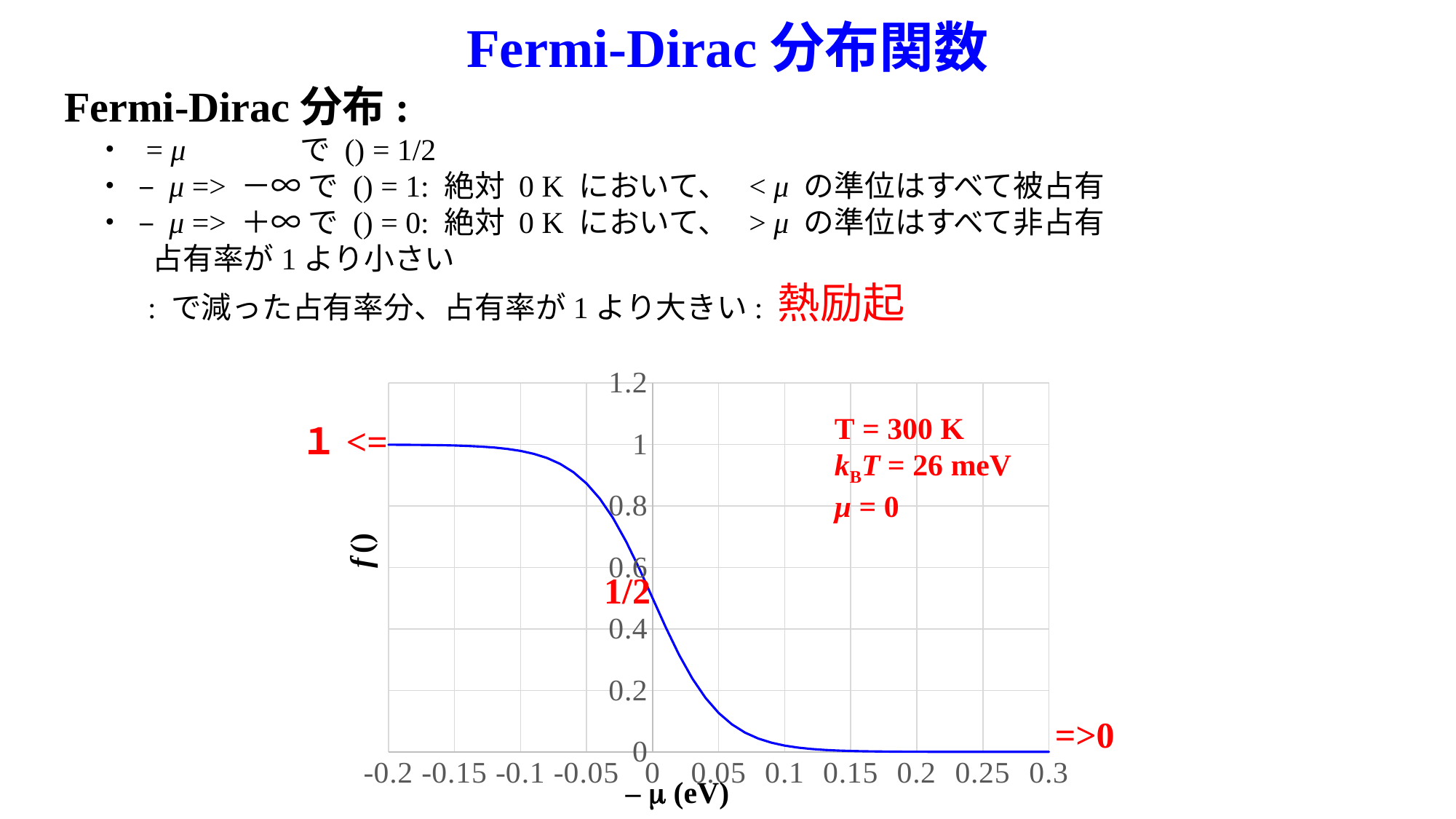
Which is larger, the plotted value at x = -0.05 or the plotted value at x = 0.05? x = -0.05 What value of kBT is stated in the annotation on the chart? 26 meV Is the plotted value at x = 0.3 greater or less than 0.2? less What temperature T is stated in the annotation on the chart? T = 300 K Is the plotted value at x = 0.1 greater or less than 0.2? less Is the plotted value at x = -0.1 greater or less than 0.8? greater According to the annotation on the chart, what is the value of the function at x = 0 (where the energy equals μ)? 1/2 Does the plotted value rise or fall as the x axis value increases from -0.2 to 0.3? fall What is the maximum value shown on the y axis of the chart? 1.2 How many lines (data series) are plotted on the chart? 1 What kind of chart is shown on the slide? line chart